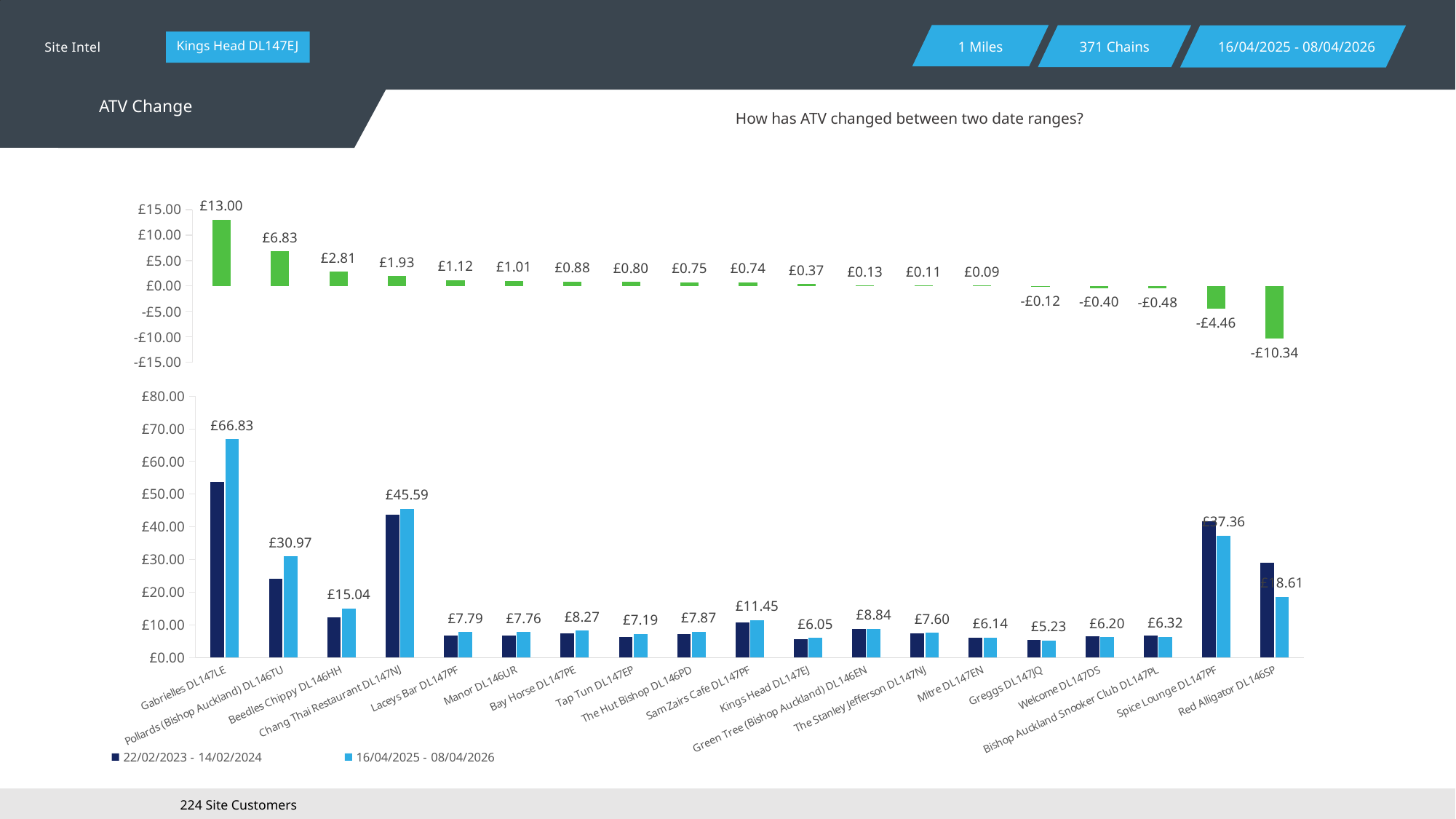
In the bottom chart, what is the difference between Pollards (Bishop Auckland) DL146TU and Beedles Chippy DL146HH in the 16/04/2025 - 08/04/2026 series? £15.93 In the bottom chart, which category has the highest value in the 16/04/2025 - 08/04/2026 series? Gabrielles DL147LE In the top chart, what is the lowest value shown? -£10.34 In the top chart, do the values rise or fall from left to right along the x axis? fall In the top chart, what is the difference between the first bar (£13.00) and the second bar (£6.83)? £6.17 In the bottom chart, what is the value for Chang Thai Restaurant DL147NJ in the 16/04/2025 - 08/04/2026 series? £45.59 How many categories are shown on the x axis of the bottom chart? 19 How many series does the legend of the bottom chart list? 2 In the bottom chart, which category has the lowest value in the 16/04/2025 - 08/04/2026 series? Greggs DL147JQ In the top chart, what is the largest value shown? £13.00 In the bottom chart, what is the value for Gabrielles DL147LE in the 16/04/2025 - 08/04/2026 series? £66.83 In the bottom chart, is the 22/02/2023 - 14/02/2024 value for Gabrielles DL147LE greater or less than £50.00? greater